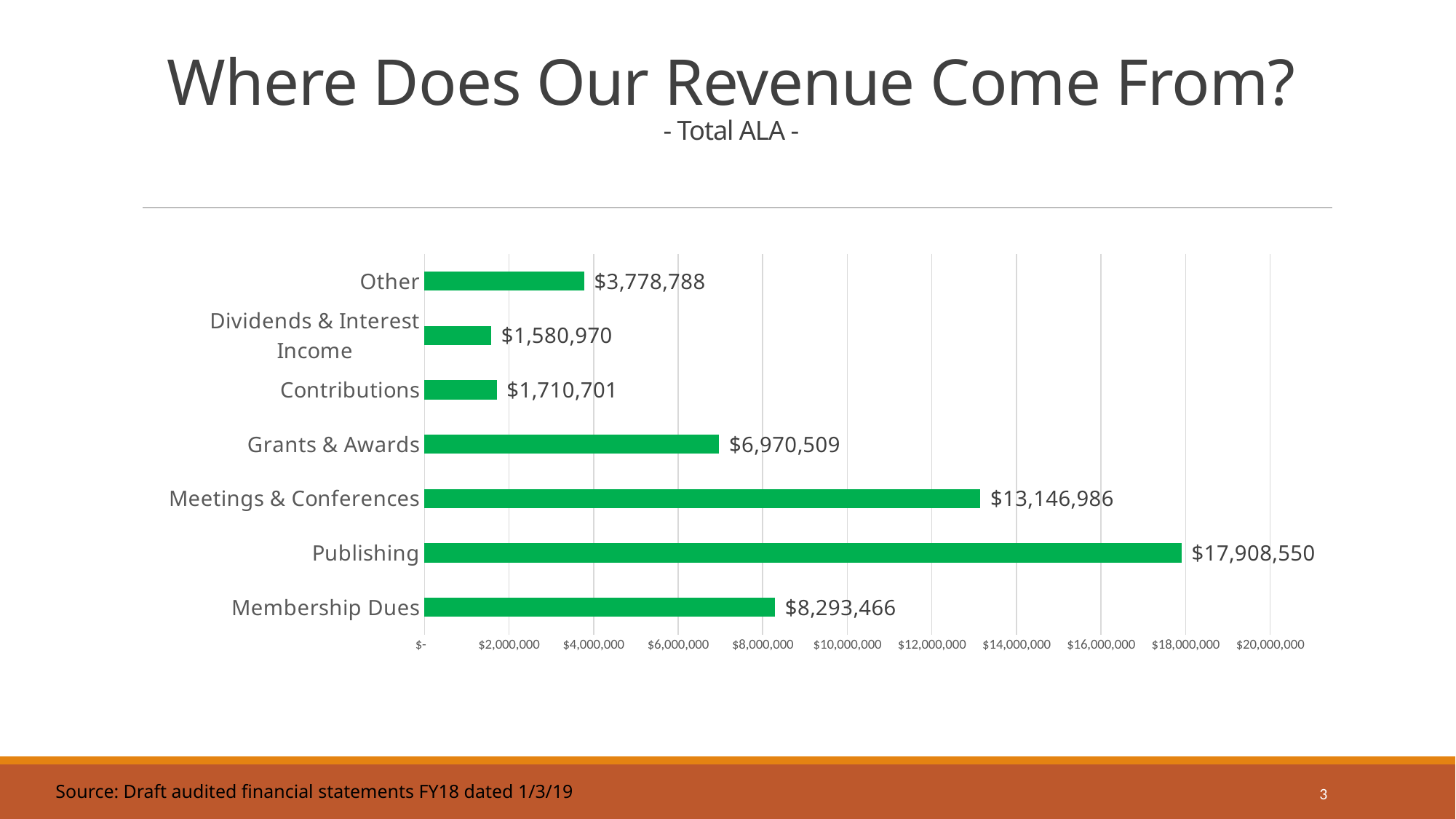
Which revenue category has the highest value? Publishing What is the revenue value for Publishing? $17,908,550 What is the difference between Publishing and Meetings & Conferences revenue? $4,761,564 What kind of chart is shown on the slide? Bar chart Which revenue category has the lowest value? Dividends & Interest Income What is the subtitle shown under the slide title? - Total ALA - Which is larger, Contributions or Dividends & Interest Income? Contributions What is the revenue value for Membership Dues? $8,293,466 What is the difference between Membership Dues and Grants & Awards revenue? $1,322,957 What is the revenue value for Dividends & Interest Income? $1,580,970 How many revenue categories are shown in the chart? 7 Is the value for Meetings & Conferences greater or less than $12,000,000? greater